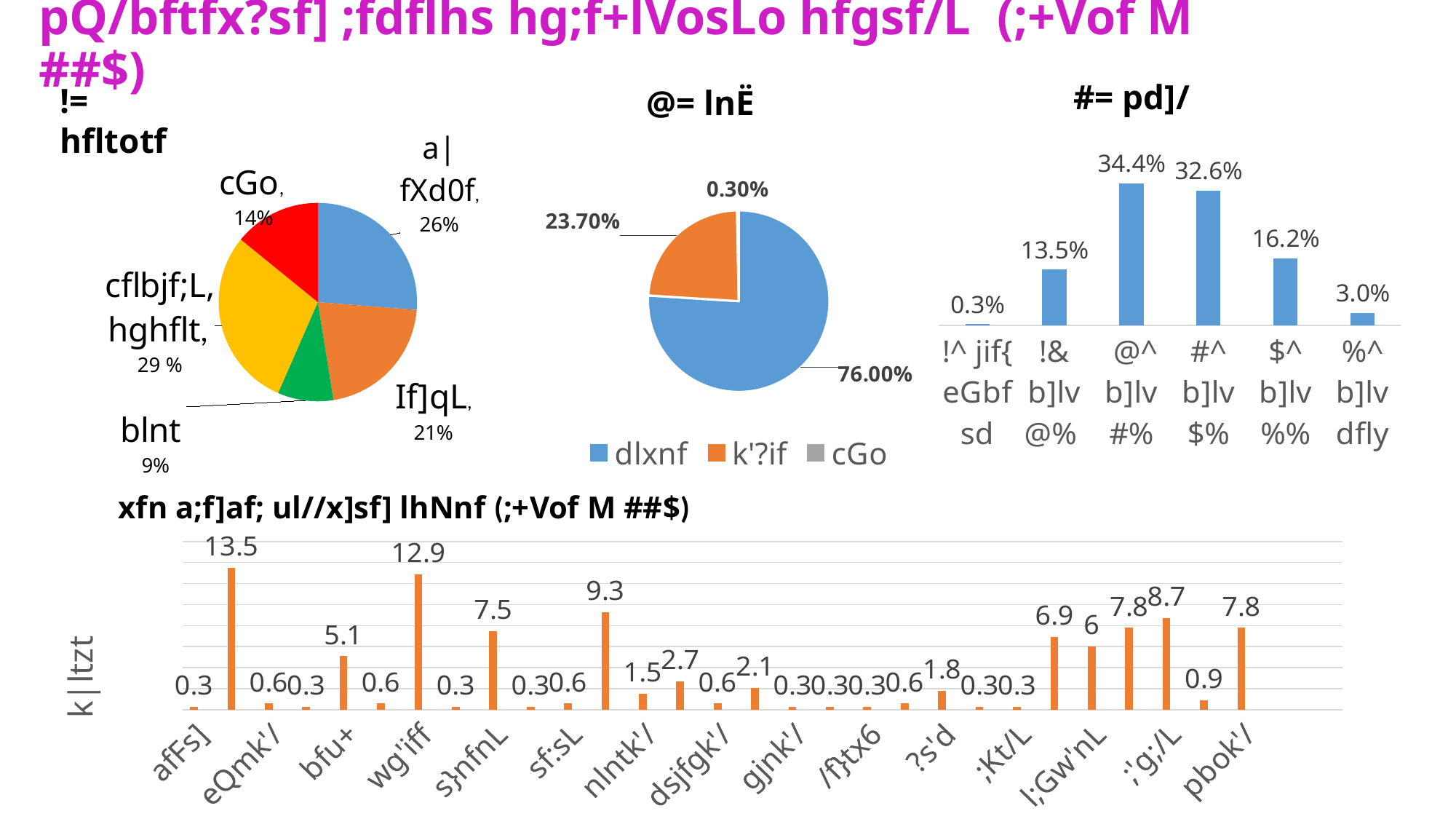
In the top-left pie chart, which slice has the largest share? cflbjf;L, hghflt (29 %) In the top-left pie chart, what percentage is shown for the slice labelled cGo? 14% In the top-right bar chart titled '#= pd]/', which category has the highest value? @^ b]lv #% (34.4%) In the top-middle pie chart titled '@= lnË', what percentage is shown for dlxnf? 76.00% How many series does the legend of the top-middle pie chart list? 3 In the top-middle pie chart titled '@= lnË', what is the difference between the dlxnf and k'?if shares? 52.30% In the top-left pie chart, which slice has the smallest share? blnt (9%) In the bottom bar chart, what is the highest value shown? 13.5 What kind of chart is the bottom chart on the slide? Bar chart In the top-left pie chart, how many slices are there? 5 In the top-right bar chart titled '#= pd]/', how many categories are shown? 6 In the top-right bar chart titled '#= pd]/', what is the value for the category '$^ b]lv %%'? 16.2%